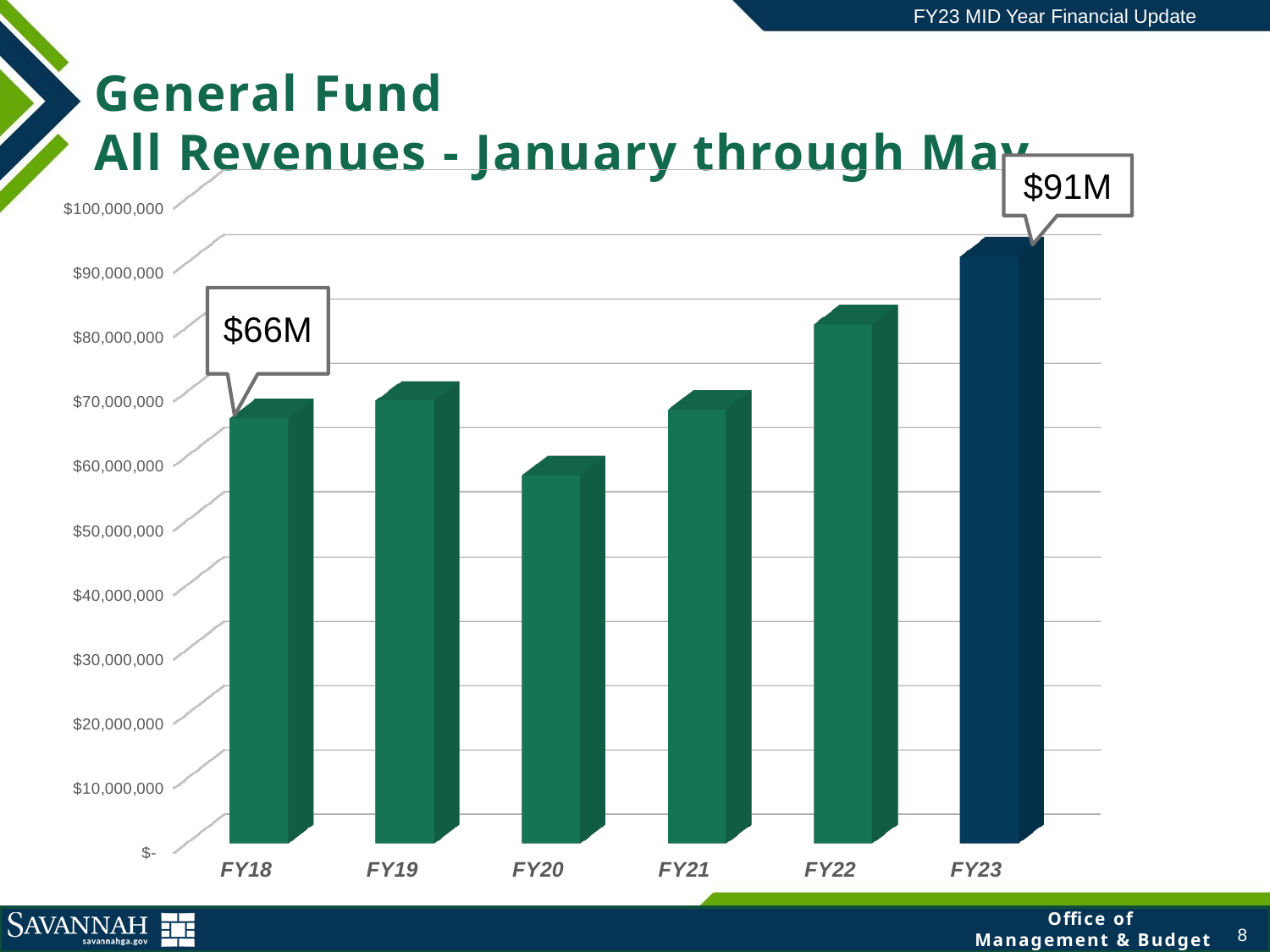
Which is larger, the value for FY22 or the value for FY21? FY22 What is the value shown for FY23? $91M Which fiscal year has the highest revenue bar? FY23 Which fiscal year has the lowest revenue bar? FY20 How many fiscal years are shown on the x axis? 6 Which fiscal year's bar is shown in a different colour (dark blue) from the others? FY23 What kind of chart is shown on the slide? Bar chart What is the value shown for FY18? $66M Is the value for FY22 greater or less than $70,000,000? greater What is the difference between the labeled values for FY23 and FY18? $25M Is the value for FY20 greater or less than $70,000,000? less Does the value rise or fall from FY22 to FY23? Rise